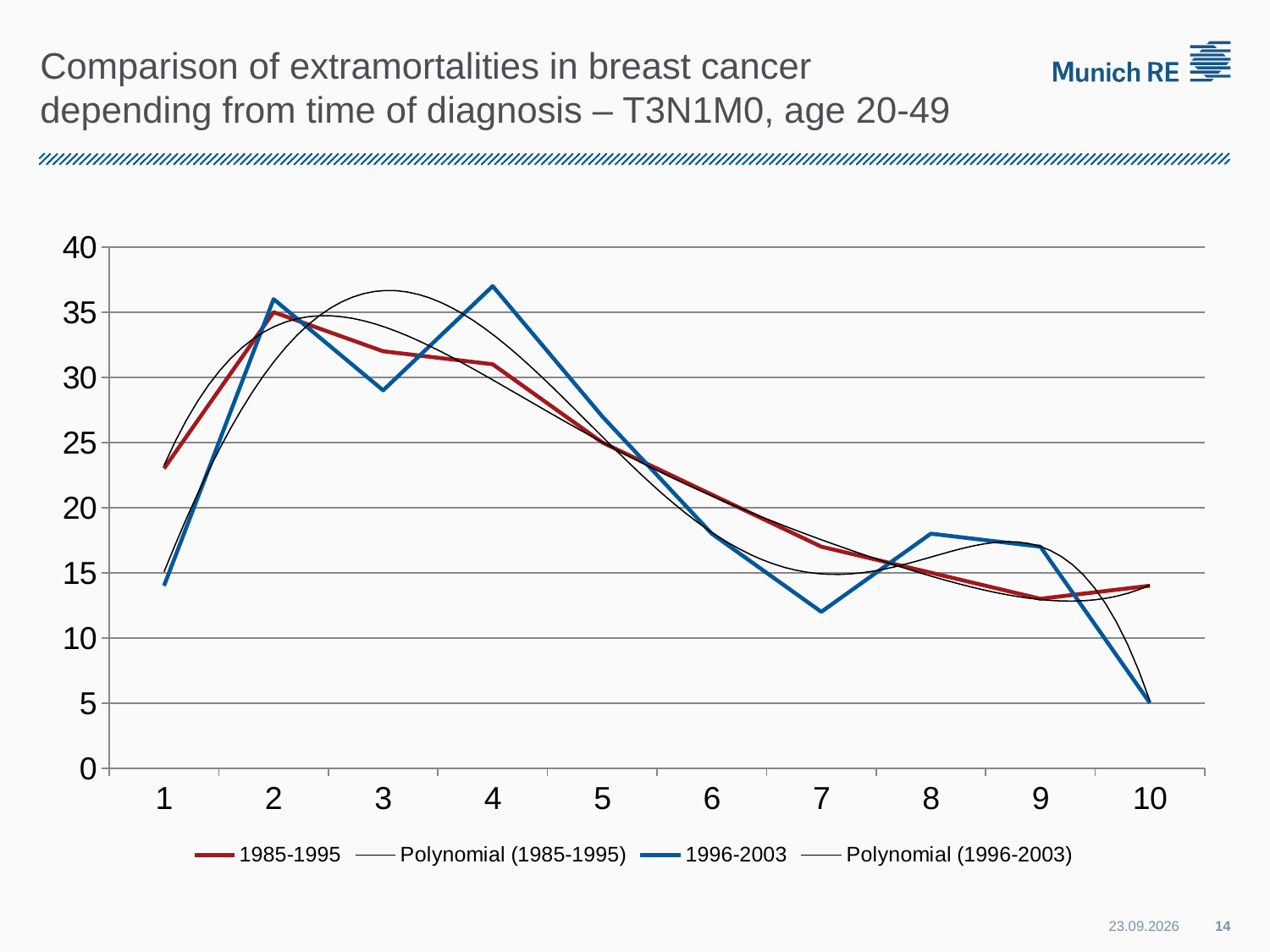
At which x value does the 1996-2003 series reach its lowest point? 10 Is the value of the 1996-2003 series at x = 7 greater or less than 15? less At x = 7, which series has the larger value, 1985-1995 or 1996-2003? 1985-1995 What kind of chart is shown on the slide? line chart At which x value does the 1996-2003 series reach its highest point? 4 What is the value of the 1996-2003 series at x = 10? 5 How many points are there along the x axis? 10 Is the value of the 1996-2003 series at x = 4 greater or less than 35? greater Does the 1996-2003 series rise or fall between x = 4 and x = 7? fall Is the value of the 1985-1995 series at x = 1 greater or less than 25? less At which x value does the 1985-1995 series reach its highest point? 2 How many entries does the legend list? 4